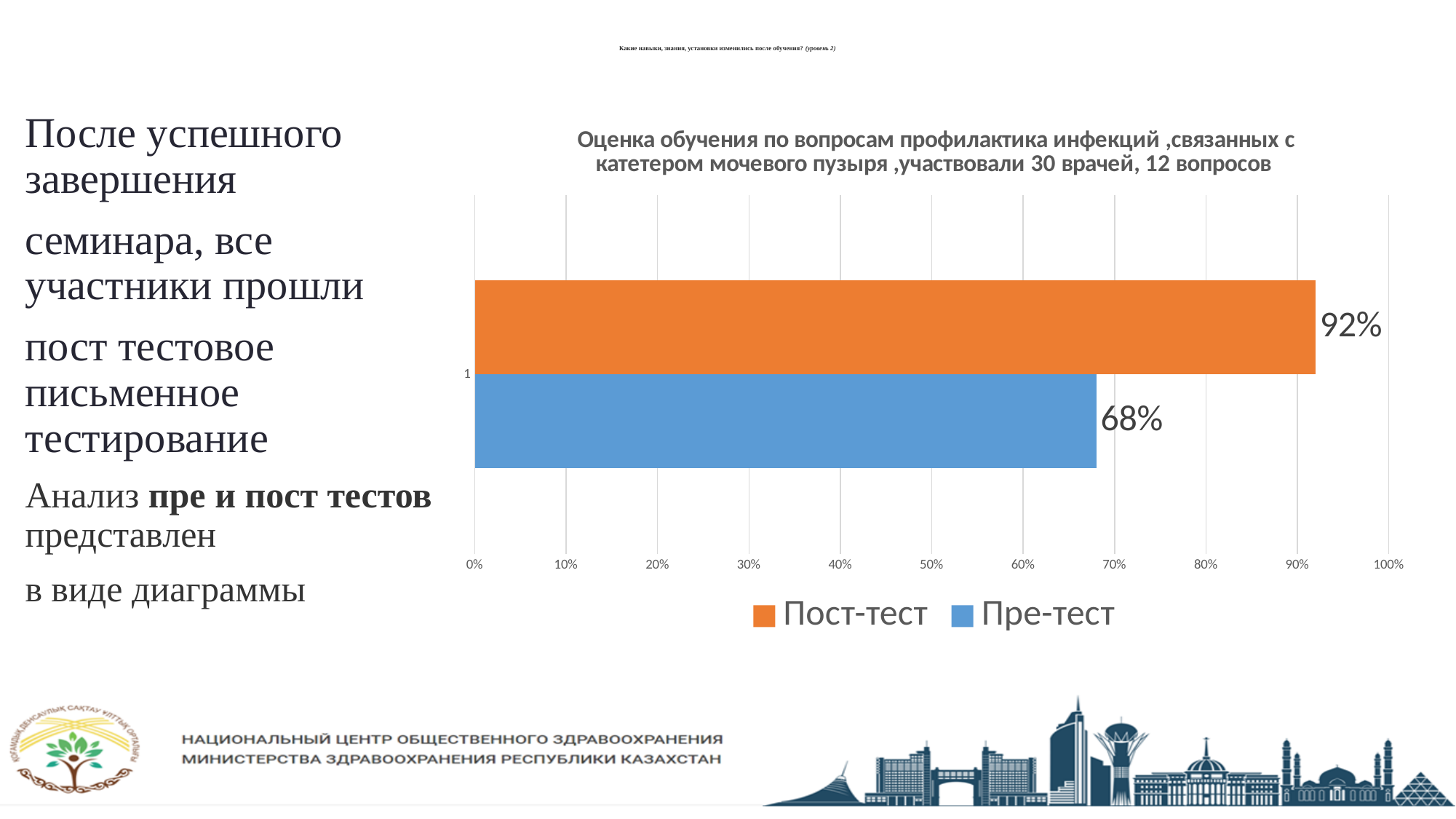
What is the value for Пре-тест? 68% Is the value for Пре-тест greater or less than 70%? less What type of chart is shown on the slide? bar chart What colour is the Пост-тест bar? orange Is the value for Пост-тест greater or less than 90%? greater Which series has the higher value, Пост-тест or Пре-тест? Пост-тест How many series does the legend list? 2 What is the difference between the Пост-тест and Пре-тест values? 24% Which series has the lowest value? Пре-тест What is the value for Пост-тест? 92% What is the maximum value shown on the x axis? 100%